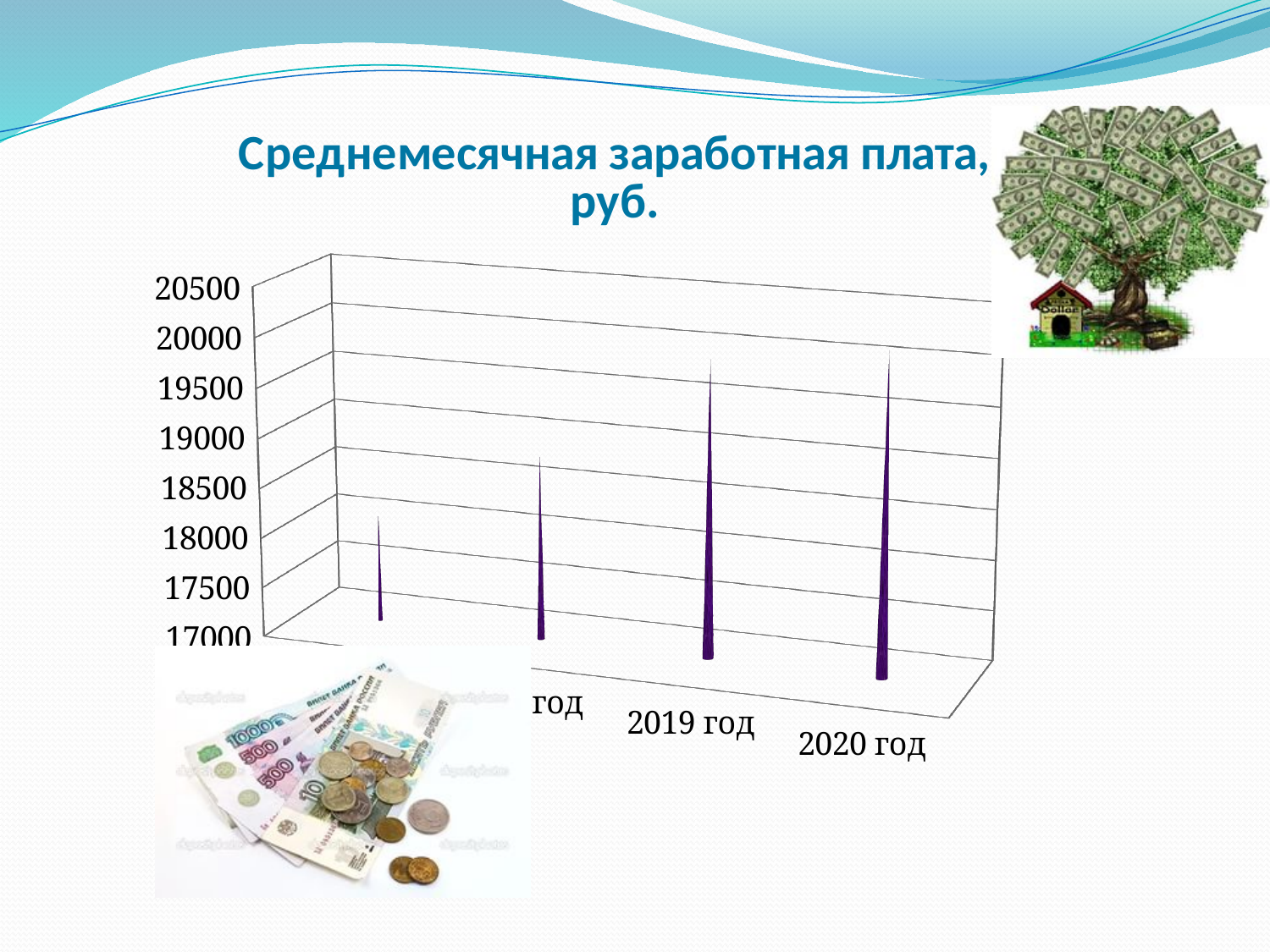
How many categories (bars) are plotted in the chart? 4 Is the value for 2019 год greater or less than 18500? greater What kind of chart is shown on the slide? bar chart What is the title of the chart? Среднемесячная заработная плата, руб. Is the value for 2020 год greater or less than 20500? less What is the highest value shown on the vertical axis? 20500 Do the values rise or fall from left to right along the x axis? rise Is the value for 2019 год greater or less than 18000? greater